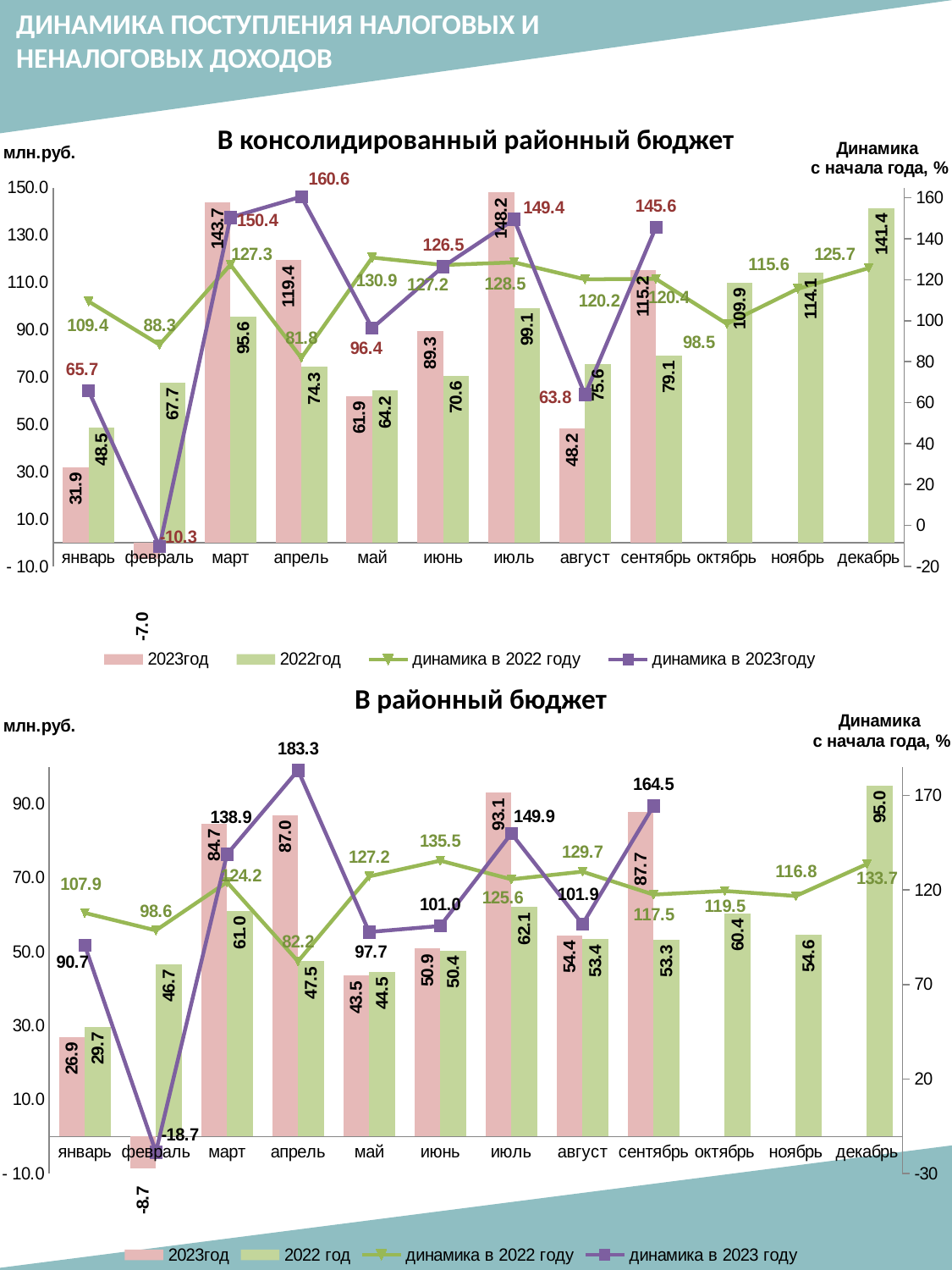
What kind of chart is 'В районный бюджет'? Combined bar and line chart In the chart 'В консолидированный районный бюджет', what is the value of the 2023год bar for июль? 148.2 In the chart 'В консолидированный районный бюджет', which month has the lowest 2023год bar? февраль In the chart 'В районный бюджет', what is the value of the 'динамика в 2023 году' line for апрель? 183.3 In the chart 'В консолидированный районный бюджет', what is the difference between the 2023год and 2022год bars for март? 48.1 In the chart 'В консолидированный районный бюджет', which month has the highest value on the 'динамика в 2023году' line? апрель In the chart 'В районный бюджет', how many months are shown on the x axis? 12 In the chart 'В консолидированный районный бюджет', how many series does the legend list? 4 In the chart 'В районный бюджет', which month has the lowest value on the 'динамика в 2022 году' line? апрель In the chart 'В районный бюджет', which is larger for июнь: the 2023год bar or the 2022 год bar? 2023год In the chart 'В консолидированный районный бюджет', what is the value of the 2022год bar for декабрь? 141.4 In the chart 'В районный бюджет', what is the value of the 2022 год bar for ноябрь? 54.6